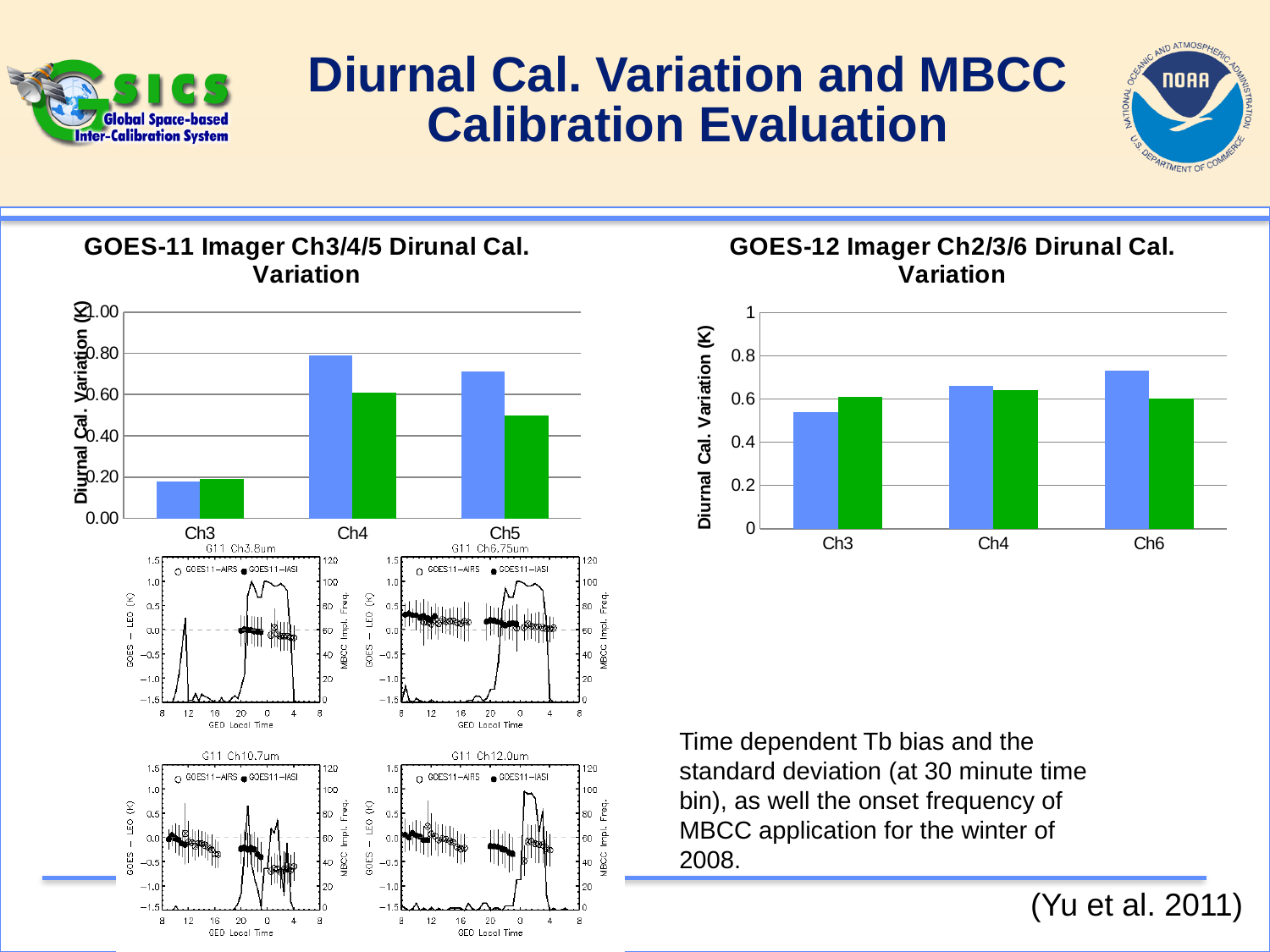
In the 'GOES-11 Imager Ch3/4/5 Dirunal Cal. Variation' chart, for Ch5, which bar is taller, the blue one or the green one? blue In the 'GOES-12 Imager Ch2/3/6 Dirunal Cal. Variation' chart, do the blue bars rise or fall from Ch3 to Ch6? rise In the 'GOES-12 Imager Ch2/3/6 Dirunal Cal. Variation' chart, is the blue bar for Ch3 greater or less than 0.4? greater In the 'GOES-11 Imager Ch3/4/5 Dirunal Cal. Variation' chart, is the blue bar for Ch4 greater or less than 0.60? greater In the 'GOES-11 Imager Ch3/4/5 Dirunal Cal. Variation' chart, which channel has the tallest blue bar? Ch4 In the 'GOES-11 Imager Ch3/4/5 Dirunal Cal. Variation' chart, is the green bar for Ch3 greater or less than 0.40? less How many channel categories are shown on the x axis of the 'GOES-11 Imager Ch3/4/5 Dirunal Cal. Variation' chart? 3 In the 'GOES-11 Imager Ch3/4/5 Dirunal Cal. Variation' chart, which channel has the shortest blue bar? Ch3 What kind of chart is the 'GOES-11 Imager Ch3/4/5 Dirunal Cal. Variation' chart? bar chart How many channel categories are shown on the x axis of the 'GOES-12 Imager Ch2/3/6 Dirunal Cal. Variation' chart? 3 In the 'GOES-12 Imager Ch2/3/6 Dirunal Cal. Variation' chart, which channel has the tallest blue bar? Ch6